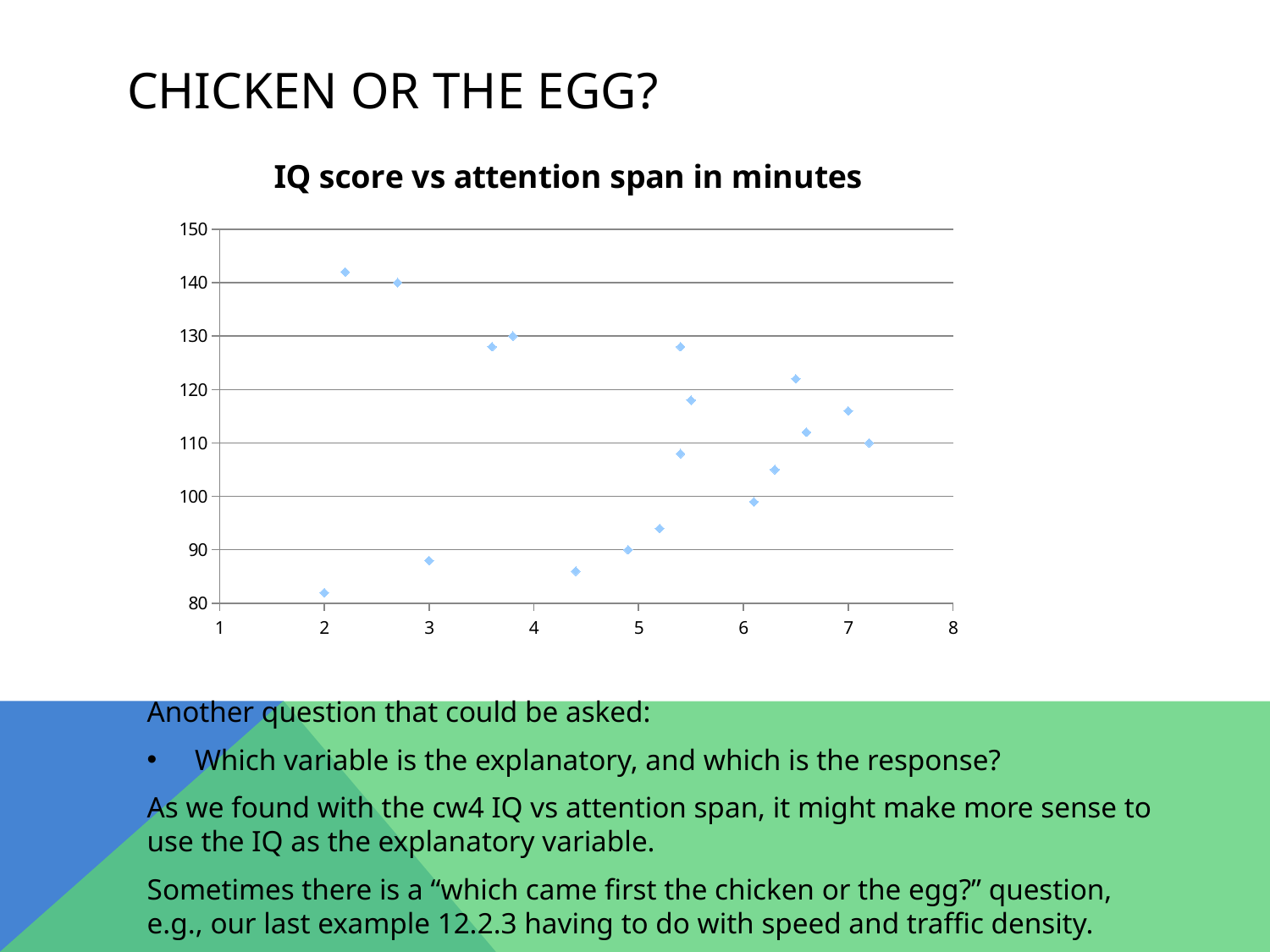
What is the title of the chart? IQ score vs attention span in minutes Is the y value of the point at about x = 6.5 greater or less than 110? greater Is the y value of the point at x = 3 greater or less than 100? less How many data points are plotted on the chart? 18 Is the y value of the highest point on the chart greater or less than 130? greater Is the lowest point on the chart located in the left half or the right half of the x-axis range? left half What is the highest value shown on the vertical axis? 150 Is the highest point on the chart located in the left half or the right half of the x-axis range? left half What kind of chart is shown on the slide? scatter chart